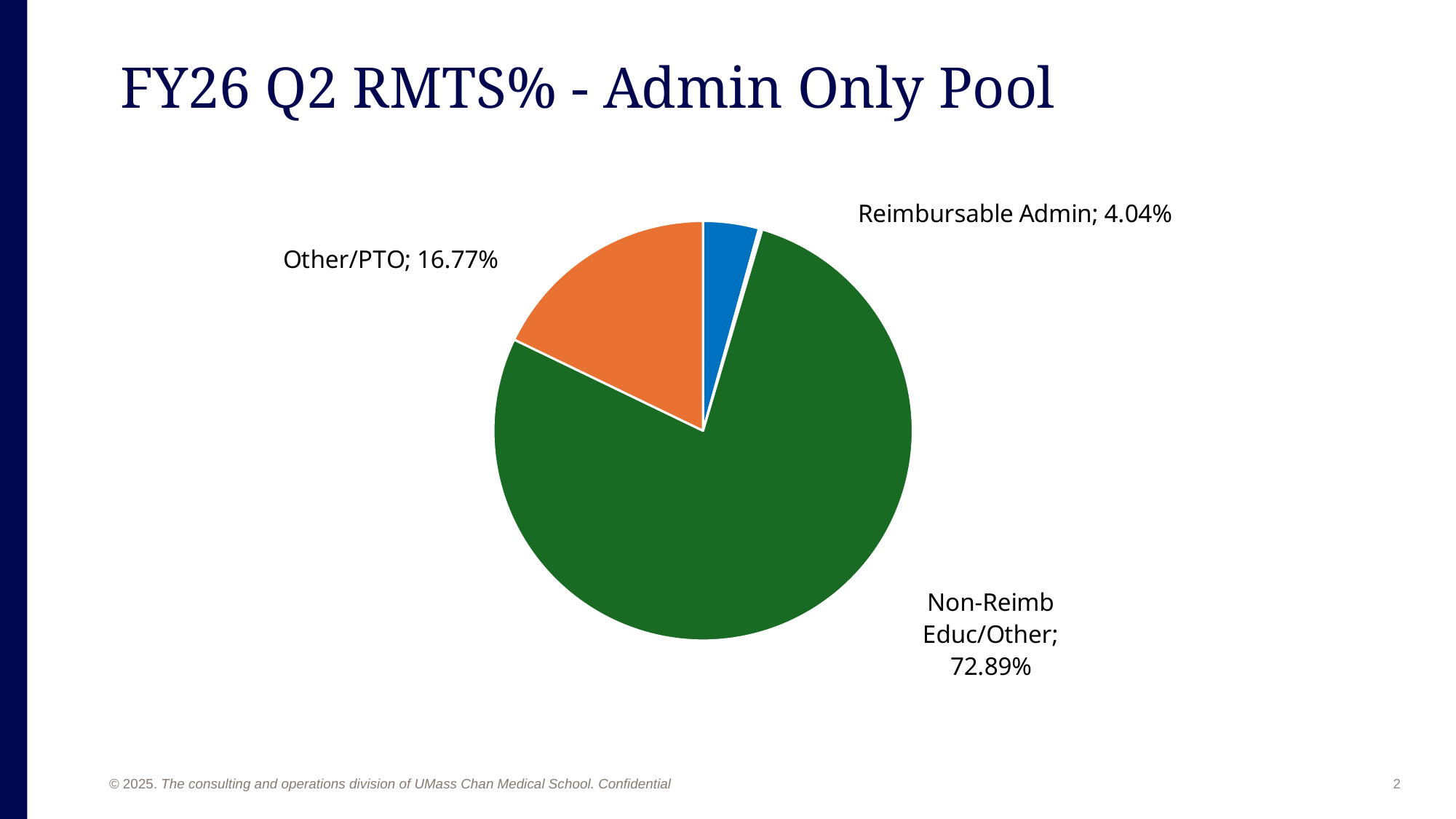
What is the value for Other/PTO? 16.77% Which category has the largest slice of the pie? Non-Reimb Educ/Other What is the title of the slide containing the chart? FY26 Q2 RMTS% - Admin Only Pool Which is larger, Other/PTO or Reimbursable Admin? Other/PTO What colour is the Other/PTO slice? orange What is the difference between the Other/PTO and Reimbursable Admin values? 12.73% What is the difference between the Non-Reimb Educ/Other and Other/PTO values? 56.12% What is the value for Reimbursable Admin? 4.04% What kind of chart is shown on the slide? pie chart What is the value for Non-Reimb Educ/Other? 72.89%